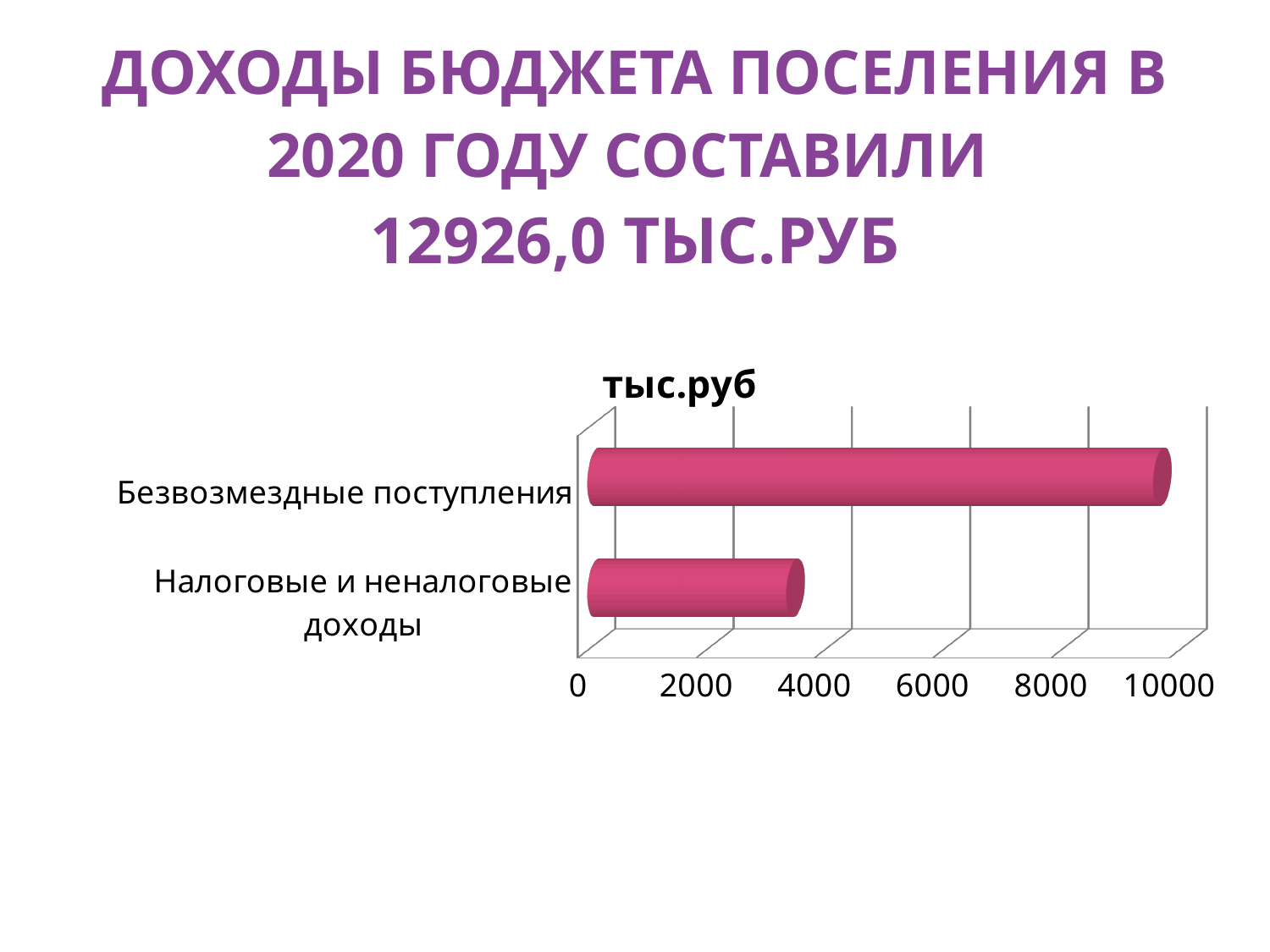
Which category has the highest value in the chart? Безвозмездные поступления Is the value for Налоговые и неналоговые доходы greater or less than 4000? less Is the value for Налоговые и неналоговые доходы greater or less than 2000? greater What is the highest value shown on the chart's horizontal axis? 10000 What is the title of the chart? тыс.руб How many categories are plotted in the chart? 2 Is the value for Безвозмездные поступления greater or less than 6000? greater What kind of chart is shown on the slide? bar chart Which category has the lowest value in the chart? Налоговые и неналоговые доходы Which is larger: the value for Безвозмездные поступления or the value for Налоговые и неналоговые доходы? Безвозмездные поступления